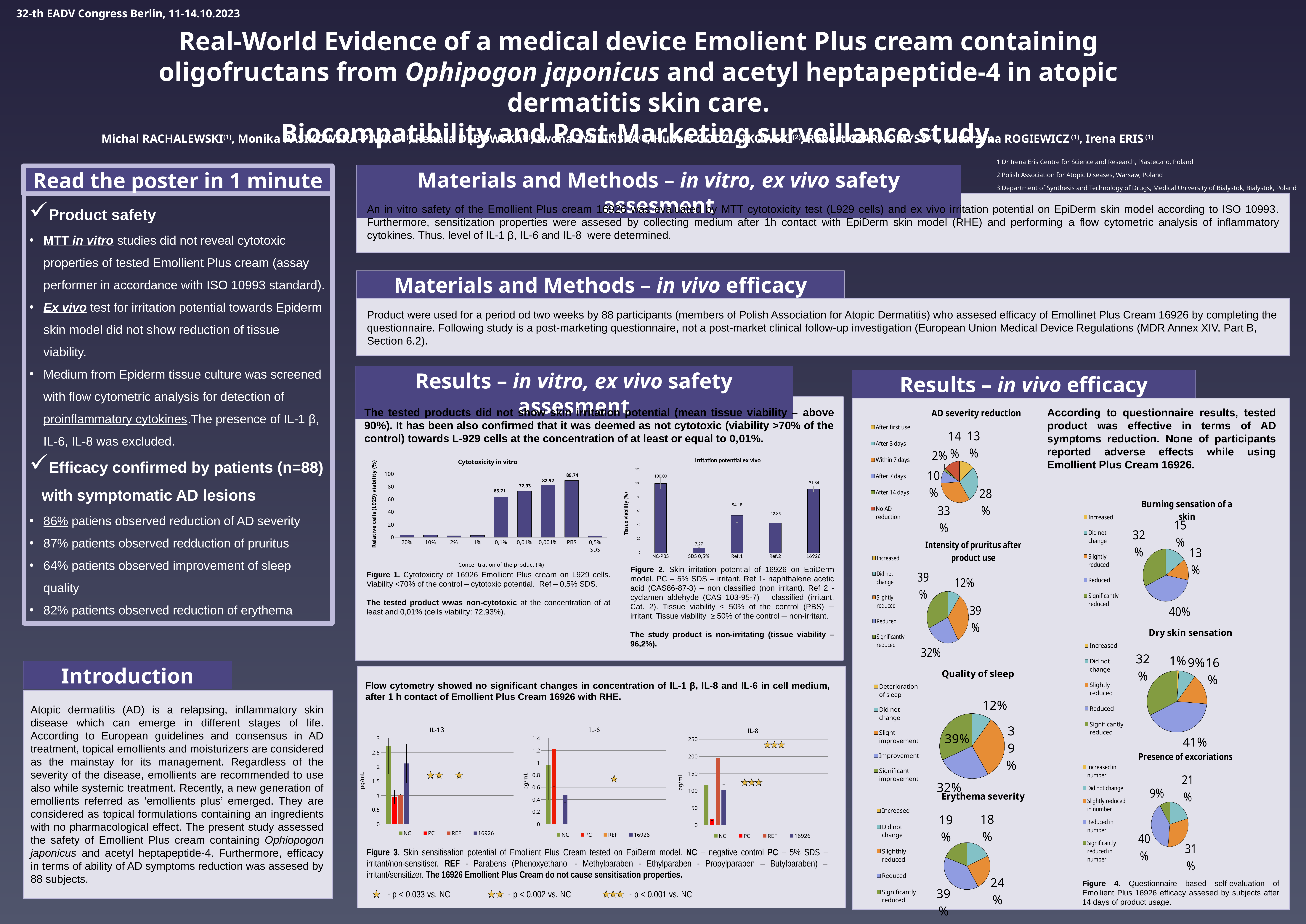
In the IL-8 chart, how many series does the legend list? 4 In the 'Cytotoxicity in vitro' chart, what is the value for PBS? 89.74 In the 'Cytotoxicity in vitro' chart, what is the relative cell viability at the 0,1% concentration? 63.71 In the 'Cytotoxicity in vitro' chart, what is the value at the 0,01% concentration? 72.93 In the 'Irritation potential ex vivo' chart, which category has the lowest tissue viability? SDS 0,5% In the 'Cytotoxicity in vitro' chart, what is the difference between the PBS value and the 0,001% value? 6.82 In the 'Cytotoxicity in vitro' chart, how many concentration categories are shown on the x axis? 9 What kind of chart is the 'Irritation potential ex vivo' chart? bar chart In the 'Cytotoxicity in vitro' chart, is the value for the 20% concentration greater or less than 20? less In the 'Irritation potential ex vivo' chart, what is the tissue viability for 16926? 91.84 In the 'Irritation potential ex vivo' chart, what is the value for SDS 0,5%? 7.27 In the 'Irritation potential ex vivo' chart, what is the difference between Ref.1 and Ref.2? 11.33